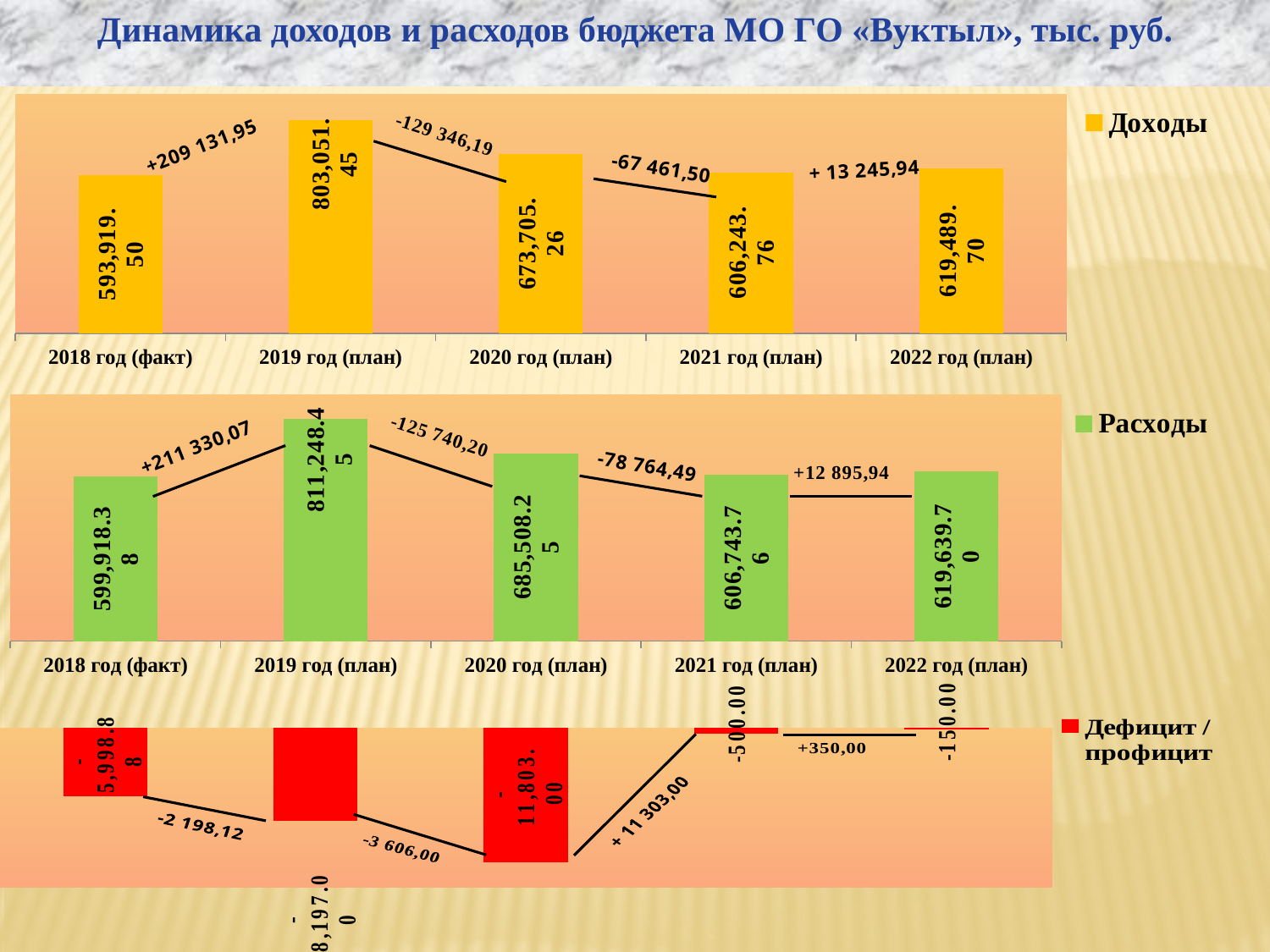
In the Доходы chart, what is the value for 2018 год (факт)? 593,919.50 In the Доходы chart, is the value for 2022 год (план) larger or smaller than the value for 2021 год (план)? larger In the Доходы chart, what change is labelled between 2019 год (план) and 2020 год (план)? -129 346,19 In the Расходы chart, which year has the lowest value? 2018 год (факт) How many years are shown in the Расходы chart? 5 What colour are the bars in the Дефицит / профицит chart? red In the Доходы chart, which year has the highest value? 2019 год (план) In the Расходы chart, what change is labelled between 2021 год (план) and 2022 год (план)? +12 895,94 What type of chart is the Доходы chart? bar chart In the Дефицит / профицит chart, what is the value for 2022 год (план)? -150.00 In the Дефицит / профицит chart, what is the value for 2020 год (план)? -11,803.00 In the Расходы chart, what is the value for 2020 год (план)? 685,508.25